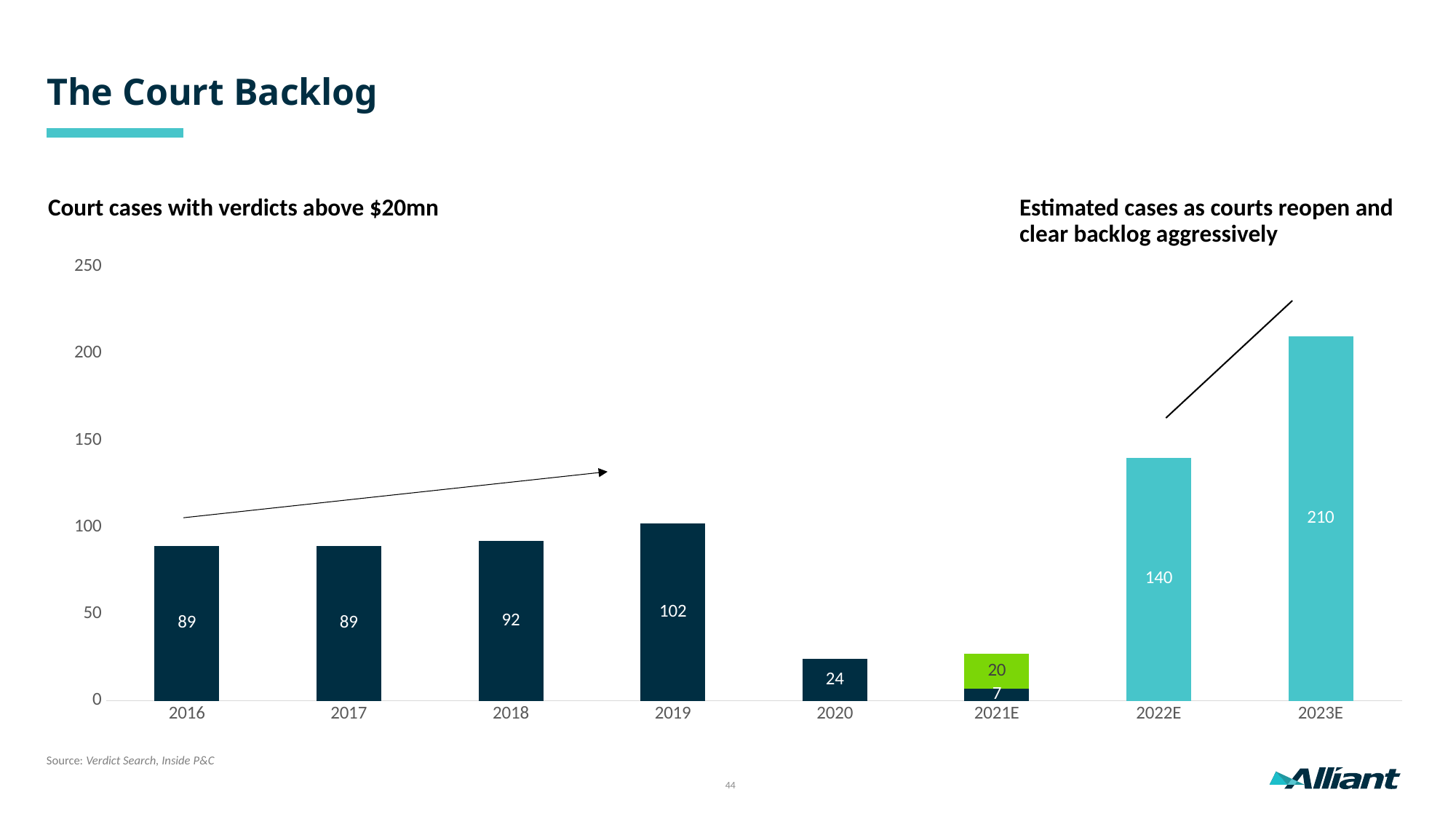
What is the value for 2020? 24 How many years are shown on the x axis? 8 Which year has the highest value? 2023E Which year has the lowest total value? 2020 Which is larger, the value for 2018 or the value for 2019? 2019 What is the total of the stacked bar for 2021E? 27 What is the value for 2023E? 210 What is the difference between the values for 2023E and 2022E? 70 Do the values rise or fall from 2016 to 2019? Rise What is the value for 2019? 102 What kind of chart is shown on the slide? Bar chart What is the title of the chart? Court cases with verdicts above $20mn